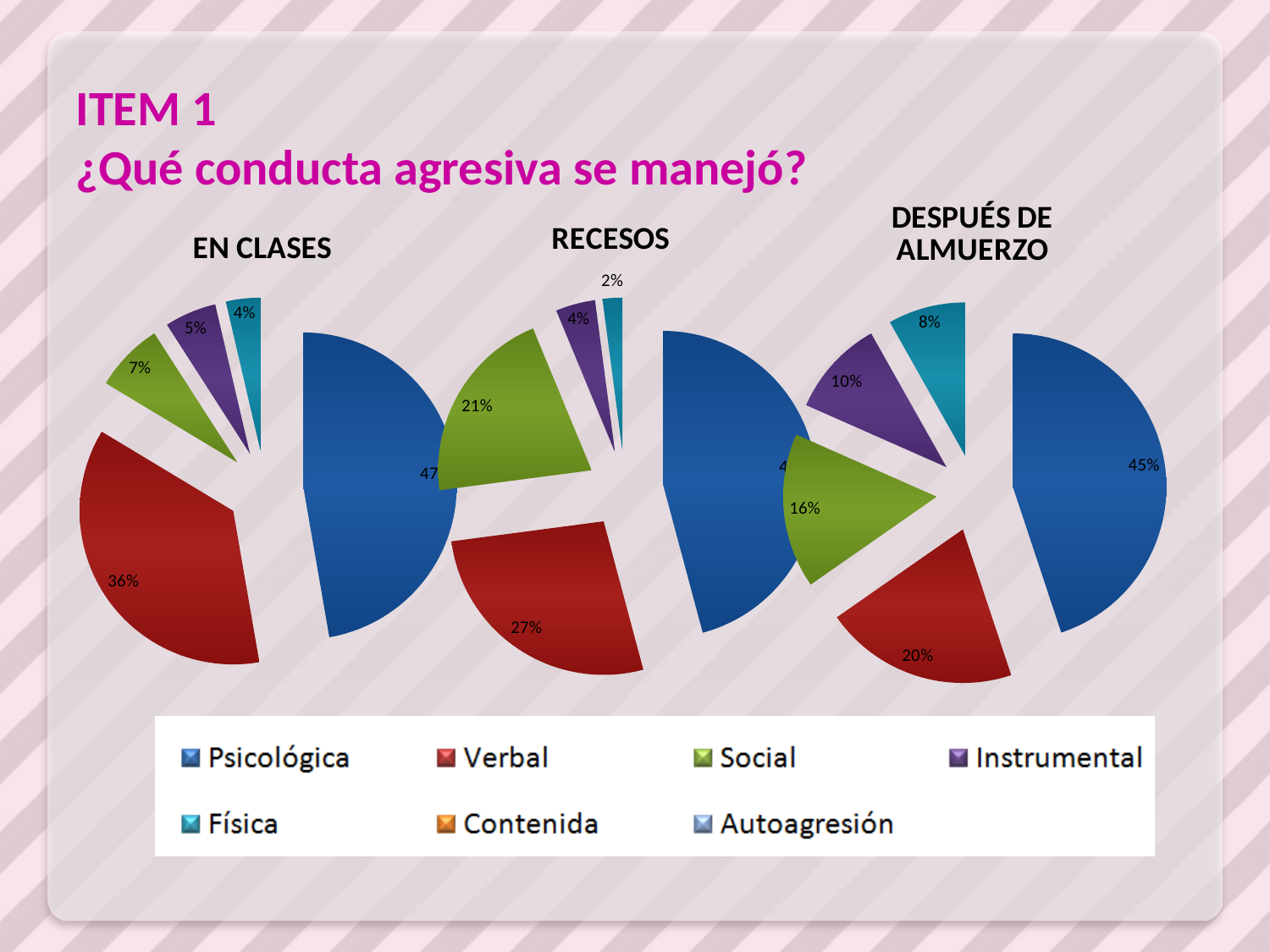
In the DESPUÉS DE ALMUERZO pie chart, which category has the largest share? Psicológica In the DESPUÉS DE ALMUERZO pie chart, what percentage is shown for Instrumental? 10% What kind of chart is used for EN CLASES, RECESOS and DESPUÉS DE ALMUERZO? Pie chart In the DESPUÉS DE ALMUERZO pie chart, which category has the smallest share? Física In the DESPUÉS DE ALMUERZO pie chart, what is the difference between the Verbal and Social shares? 4% In the DESPUÉS DE ALMUERZO pie chart, what percentage is shown for Psicológica? 45% How many entries does the shared legend list? 7